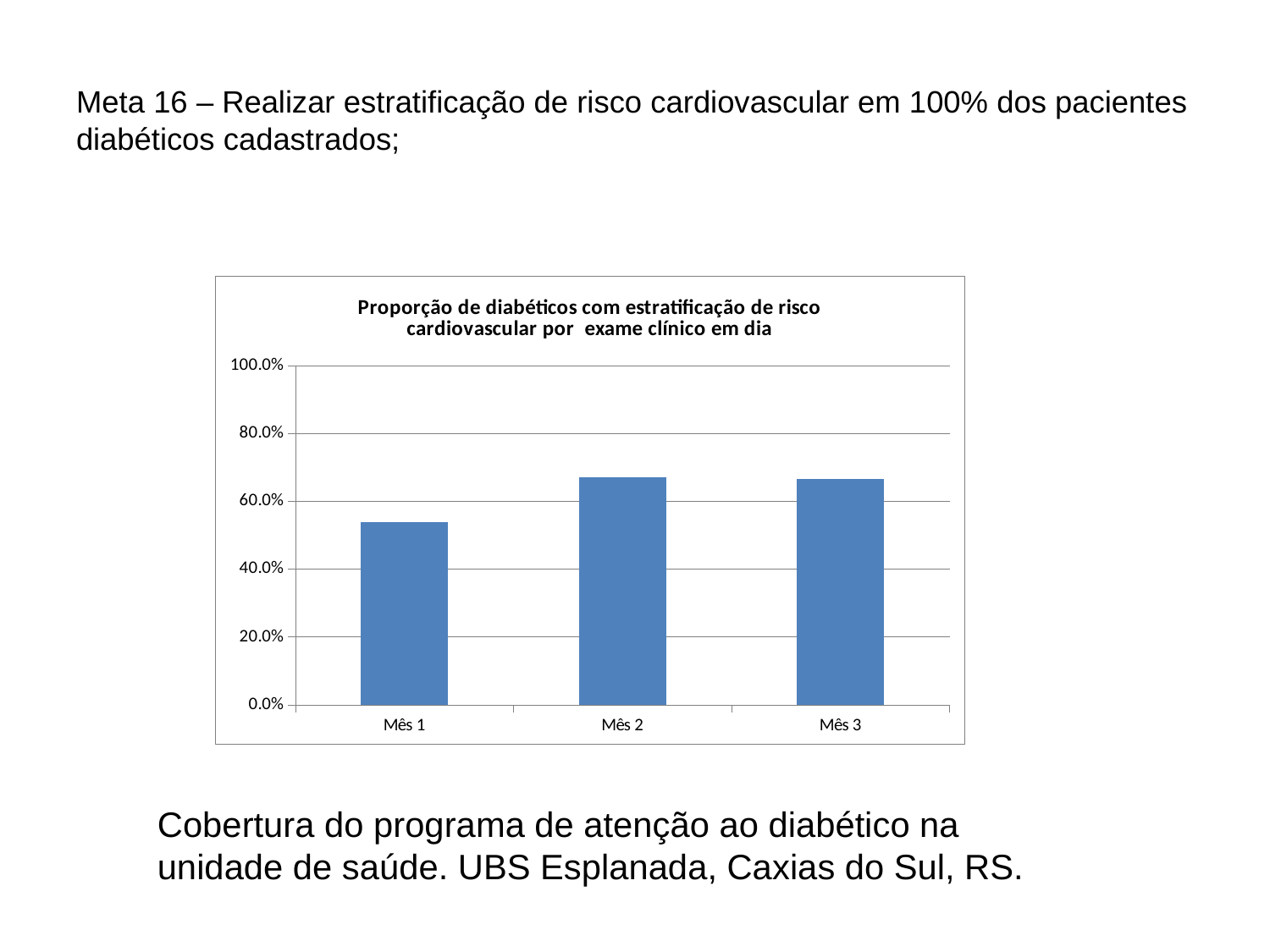
Which is larger, the value for Mês 1 or the value for Mês 2? Mês 2 How many categories (months) are plotted on the chart? 3 Does the value rise or fall from Mês 1 to Mês 2? rise Is the value for Mês 2 greater or less than 60.0%? greater What kind of chart is shown on the slide? bar chart Is the value for Mês 2 greater or less than 80.0%? less Is the value for Mês 1 greater or less than 40.0%? greater What is the title of the chart? Proporção de diabéticos com estratificação de risco cardiovascular por exame clínico em dia Which month has the lowest proportion of diabetics with cardiovascular risk stratification? Mês 1 Which is larger, the value for Mês 1 or the value for Mês 3? Mês 3